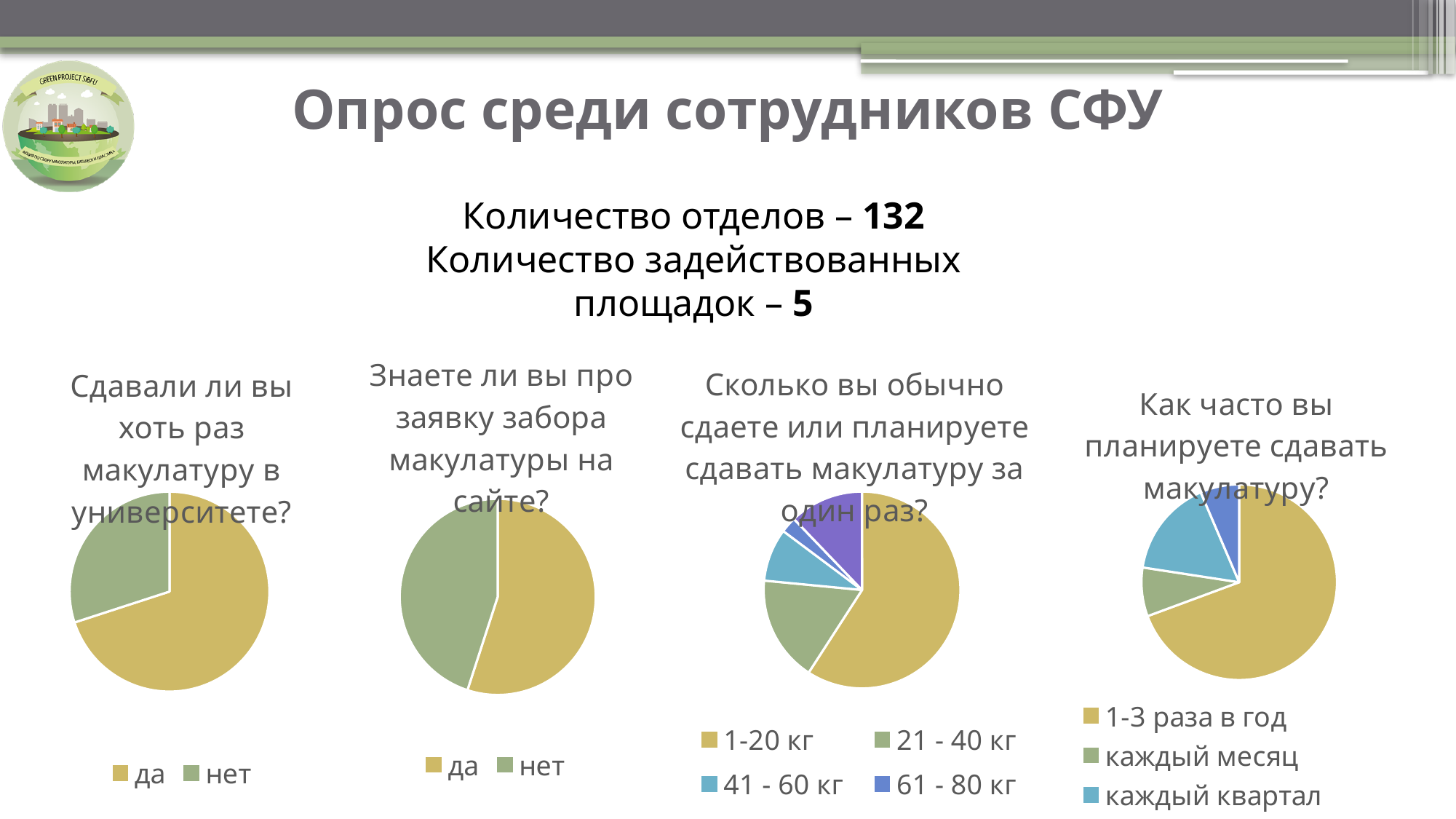
In the chart "Сколько вы обычно сдаете или планируете сдавать макулатуру за один раз?", which is larger, 1-20 кг or 21 - 40 кг? 1-20 кг How many pie charts are shown on the slide? 4 How many entries does the legend of the chart "Как часто вы планируете сдавать макулатуру?" list? 3 In the chart "Сколько вы обычно сдаете или планируете сдавать макулатуру за один раз?", which category has the largest share? 1-20 кг In the chart "Сдавали ли вы хоть раз макулатуру в университете?", which answer has the largest share? да What kind of chart is used for the question "Сдавали ли вы хоть раз макулатуру в университете?"? pie chart In the chart "Сколько вы обычно сдаете или планируете сдавать макулатуру за один раз?", what colour represents 61 - 80 кг? blue In the chart "Сдавали ли вы хоть раз макулатуру в университете?", which answer has the smallest share? нет In the chart "Как часто вы планируете сдавать макулатуру?", which category has the largest share? 1-3 раза в год In the chart "Как часто вы планируете сдавать макулатуру?", which is larger, каждый месяц or каждый квартал? каждый квартал In the chart "Знаете ли вы про заявку забора макулатуры на сайте?", which is larger, да or нет? да How many entries does the legend of the chart "Сколько вы обычно сдаете или планируете сдавать макулатуру за один раз?" list? 4